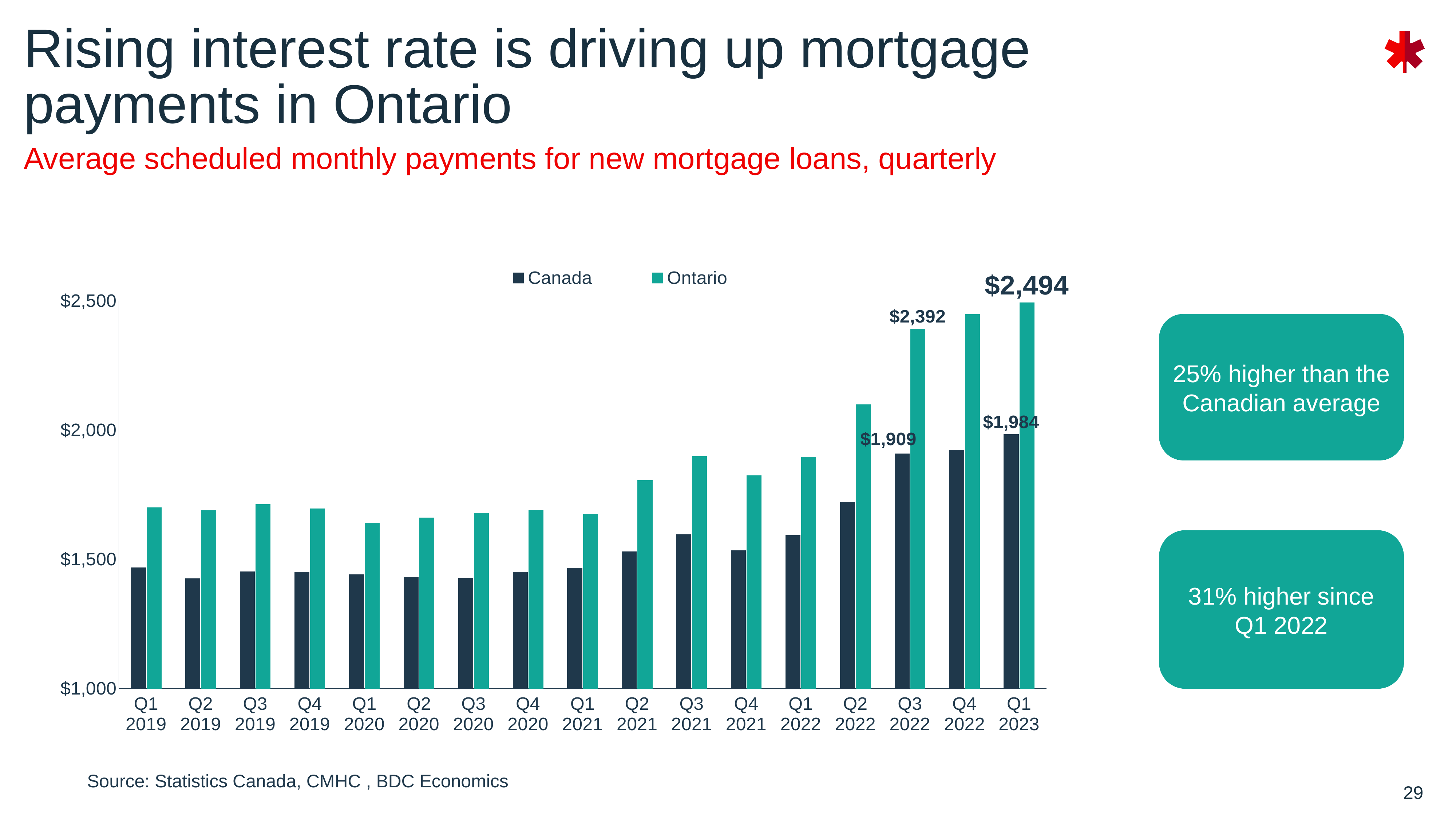
Is the Canada value for Q1 2019 greater or less than $1,500? less What is the difference between the Ontario and Canada values in Q1 2023? $510 What is the Ontario value for Q1 2023? $2,494 What is the Canada value for Q1 2023? $1,984 By how much did the Ontario value increase from Q3 2022 to Q1 2023? $102 Which quarter has the highest Ontario value? Q1 2023 What is the Ontario value for Q3 2022? $2,392 How many quarters are shown on the x axis? 17 Is the Ontario value for Q2 2022 greater or less than $2,000? greater Which is larger in Q3 2022, the Canada value or the Ontario value? Ontario How many series does the legend list? 2 What is the Canada value for Q3 2022? $1,909